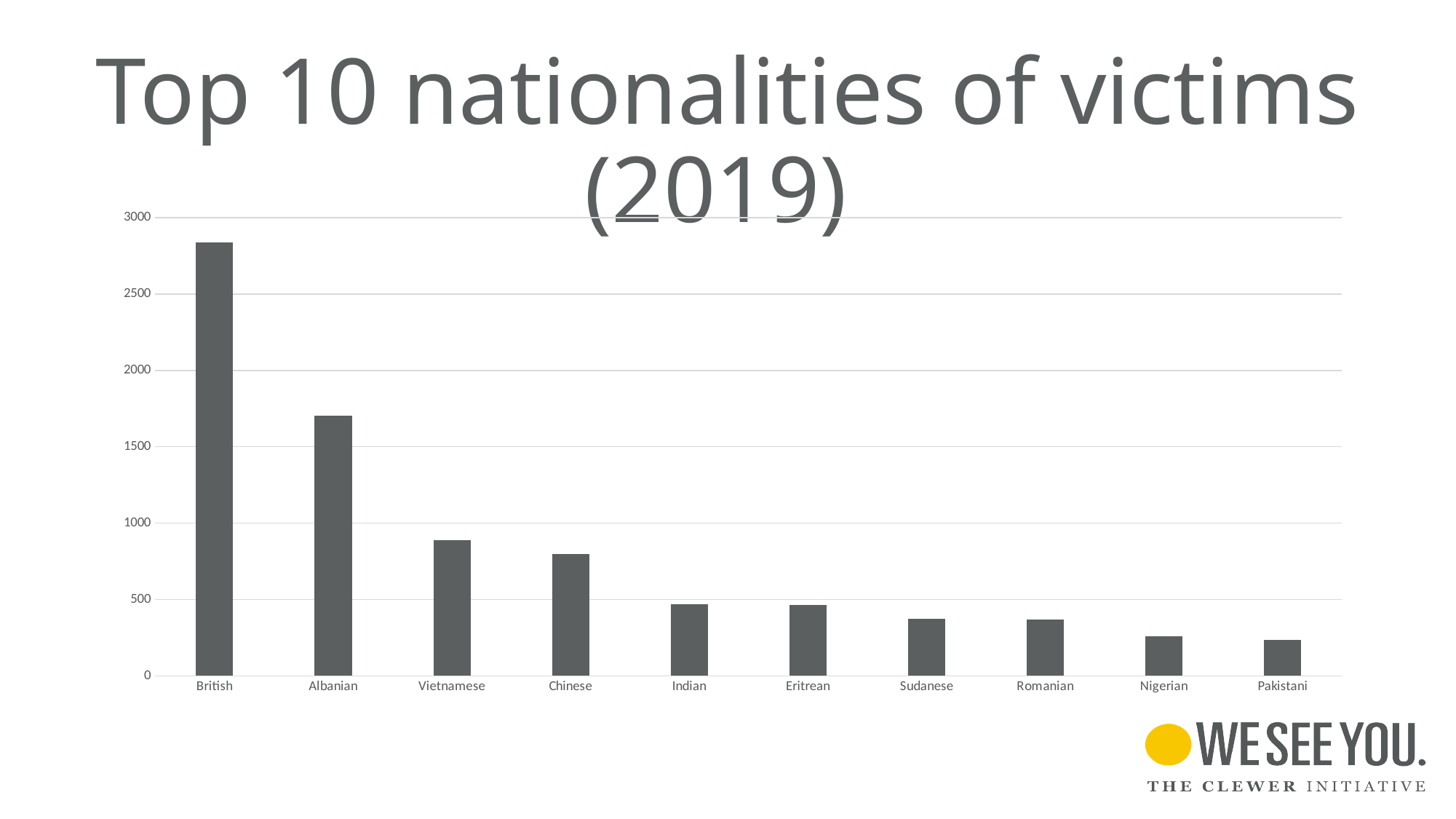
How many nationalities are shown on the x axis of the chart? 10 Is the value for Sudanese greater or less than 500? less Which has a larger value, Albanian or Vietnamese? Albanian Is the value for Albanian greater or less than 2000? less Which nationality has the highest number of victims in the chart? British Which nationality has the lowest number of victims in the chart? Pakistani Is the value for Chinese greater or less than 500? greater What kind of chart is shown on the slide? bar chart Do the values rise or fall moving from left to right along the x axis? fall What is the title of the chart on the slide? Top 10 nationalities of victims (2019)